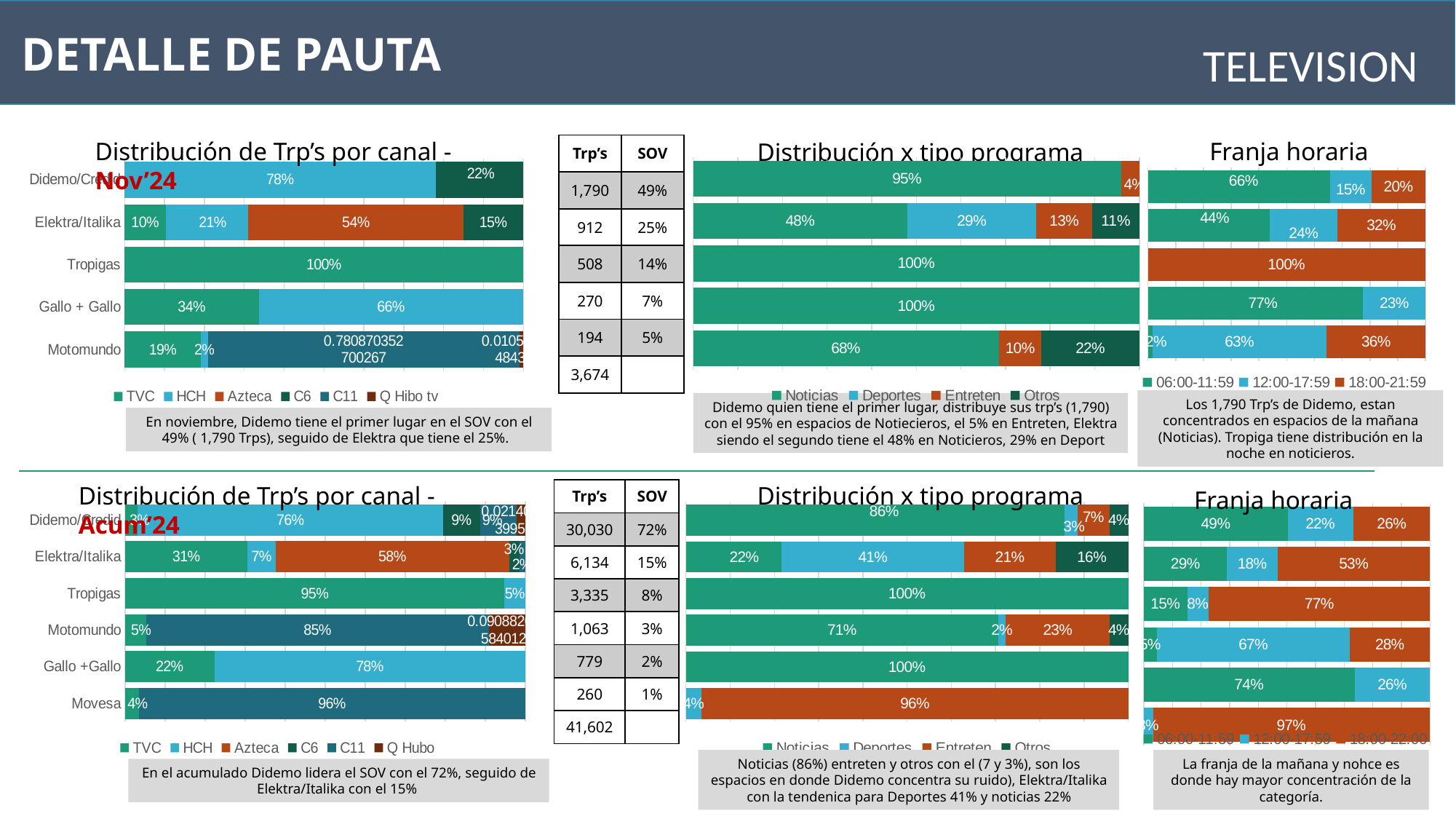
In the 'Distribución de Trp's por canal - Nov'24' chart, which channel has 100% of its Trp's on TVC? Tropigas In the 'Distribución de Trp's por canal - Acum'24' chart, what is the C11 share for Movesa? 96% In the 'Distribución de Trp's por canal - Acum'24' chart, what is the TVC share for Tropigas? 95% In the 'Distribución de Trp's por canal - Nov'24' chart, what is the HCH share for Didemo/Credit? 78% In the 'Distribución de Trp's por canal - Acum'24' chart, how many channels are listed? 6 In the 'Distribución de Trp's por canal - Nov'24' chart, what is the Azteca share for Elektra/Italika? 54% What kind of chart is the 'Distribución de Trp's por canal - Acum'24' chart? Stacked bar chart In the 'Distribución de Trp's por canal - Nov'24' chart, what is the difference between the HCH and TVC shares for Gallo + Gallo? 32% In the 'Distribución de Trp's por canal - Nov'24' chart, how many series does the legend list? 6 In the top 'Distribución x tipo programa' chart (Nov'24), what are the four legend entries? Noticias, Deportes, Entreten, Otros In the 'Distribución de Trp's por canal - Acum'24' chart, which is larger for Elektra/Italika: the TVC share or the Azteca share? Azteca In the top 'Franja horaria' chart (Nov'24), what time slot does the first legend entry show? 06:00-11:59